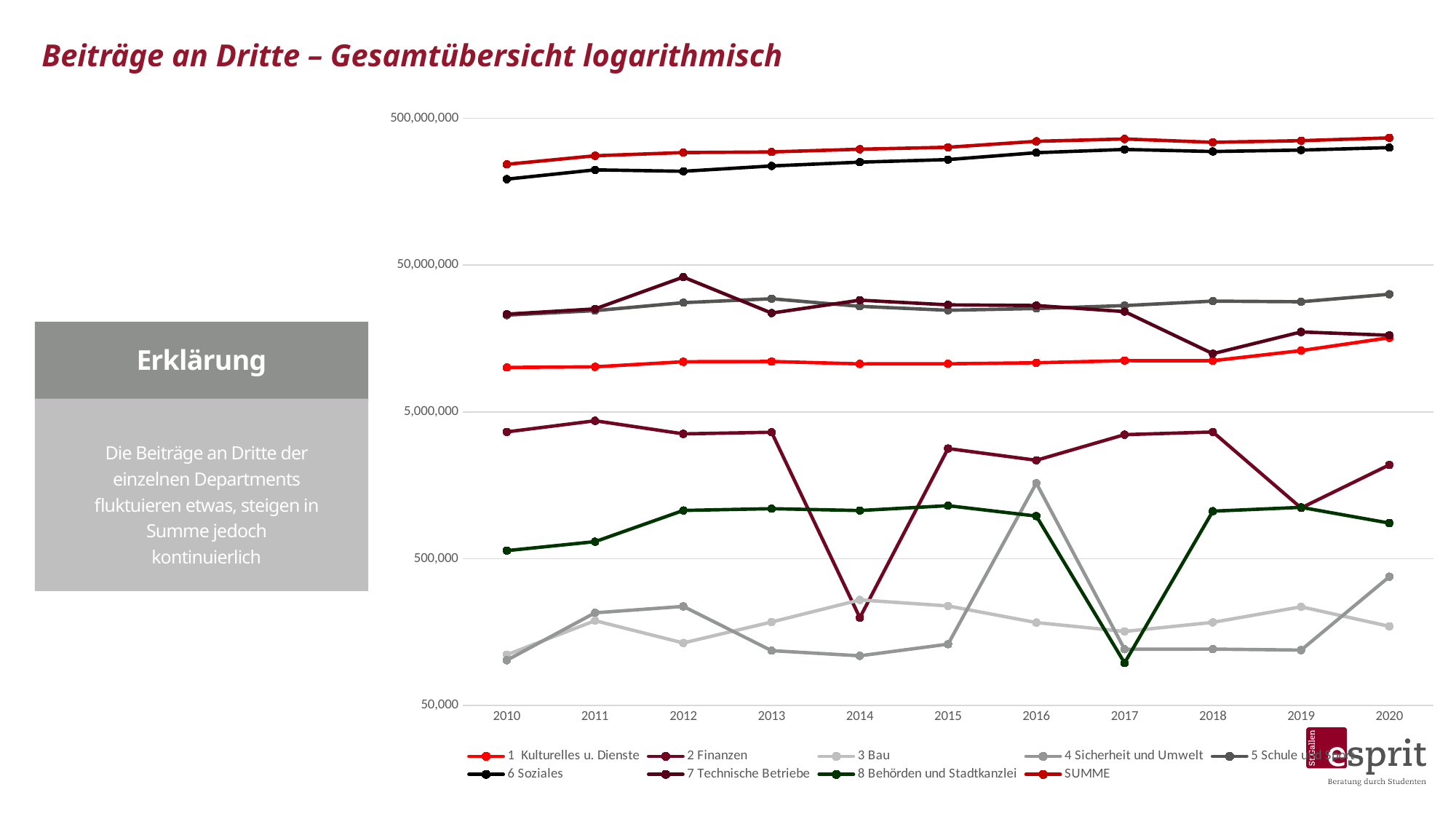
Which department series has the highest value in 2020? 6 Soziales Does the SUMME series rise or fall from 2010 to 2020? rise Is the value for 3 Bau in 2010 greater or less than 500,000? less Which is larger in 2015, 6 Soziales or 1 Kulturelles u. Dienste? 6 Soziales Is the value for 1 Kulturelles u. Dienste in 2010 greater or less than 5,000,000? greater Is the value for 6 Soziales in 2010 greater or less than 50,000,000? greater Which series has the highest values across all years? SUMME What kind of chart is shown on the slide? line chart How many years are plotted along the x axis? 11 How many series does the legend list? 9